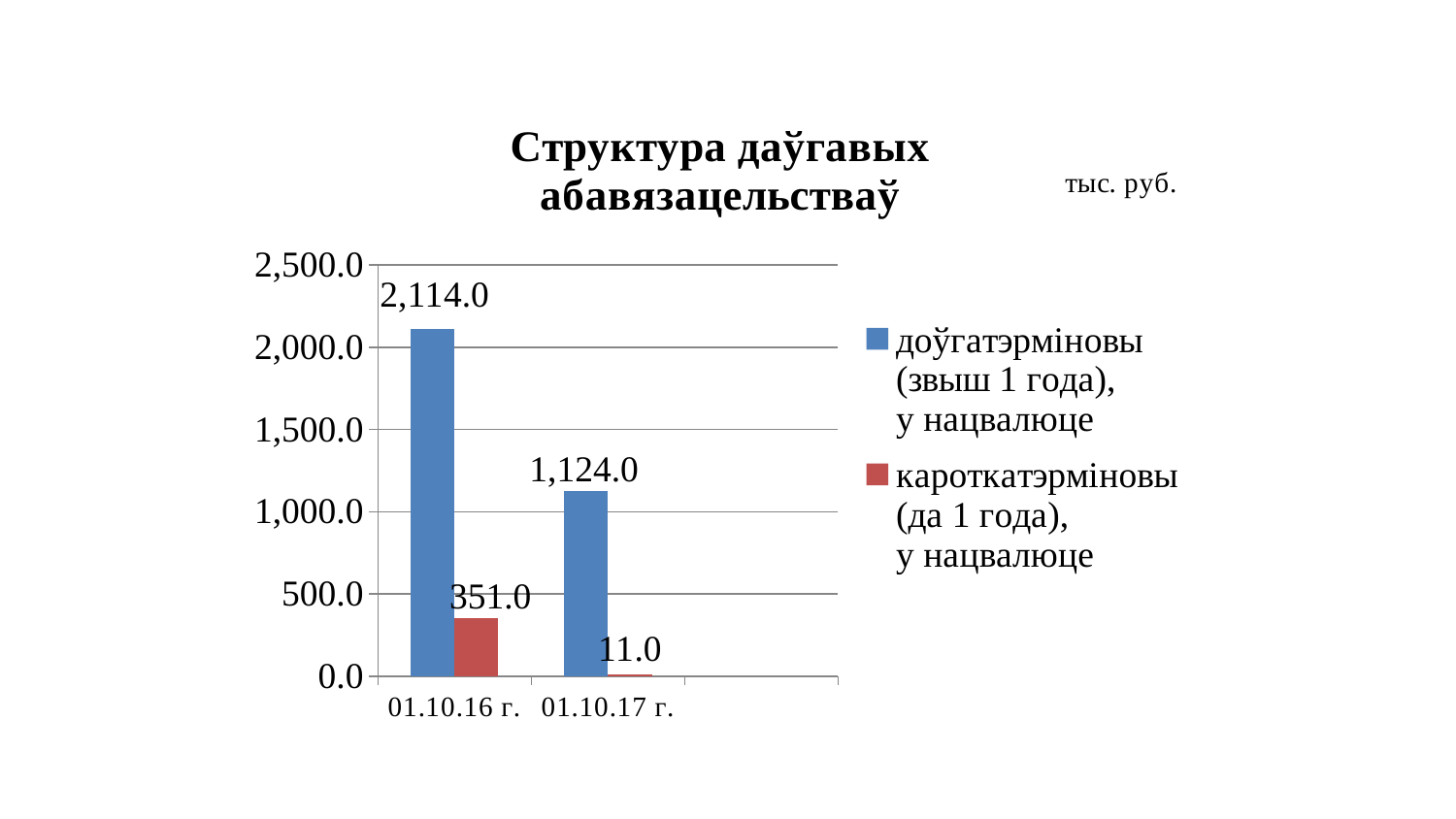
What is the value of the short-term (кароткатэрміновы) series for 01.10.16 г.? 351.0 What kind of chart is shown on the slide? bar chart How many series does the legend list? 2 What is the difference between the long-term values for 01.10.16 г. and 01.10.17 г.? 990.0 What is the value of the long-term (доўгатэрміновы) series for 01.10.17 г.? 1,124.0 How many dates (categories) are shown on the x axis? 2 Which date has the highest long-term (доўгатэрміновы) value? 01.10.16 г. Which date has the lowest short-term (кароткатэрміновы) value? 01.10.17 г. What is the value of the long-term (доўгатэрміновы) series for 01.10.16 г.? 2,114.0 Which is larger: the short-term value for 01.10.16 г. or the long-term value for 01.10.17 г.? the long-term value for 01.10.17 г. What is the value of the short-term (кароткатэрміновы) series for 01.10.17 г.? 11.0 What unit is indicated next to the chart title? тыс. руб.